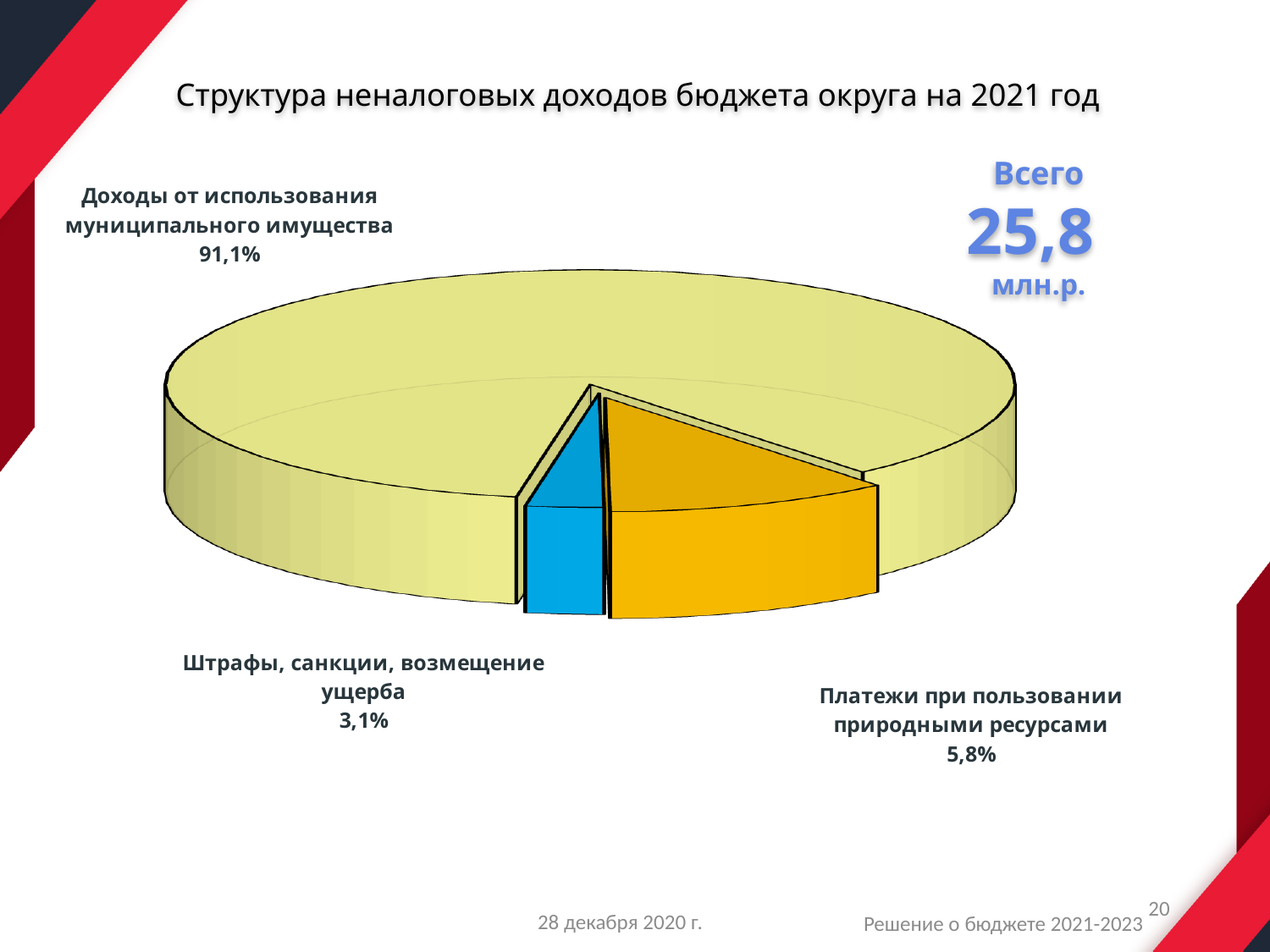
What share of non-tax revenues comes from 'Штрафы, санкции, возмещение ущерба'? 3,1% How many slices does the pie chart have? 3 Which category has the smallest share of the pie? Штрафы, санкции, возмещение ущерба What is the difference in percentage points between 'Платежи при пользовании природными ресурсами' and 'Штрафы, санкции, возмещение ущерба'? 2,7 What type of chart is shown on the slide? pie chart What share of non-tax revenues comes from 'Доходы от использования муниципального имущества'? 91,1% Which is larger: the share for 'Платежи при пользовании природными ресурсами' or for 'Штрафы, санкции, возмещение ущерба'? Платежи при пользовании природными ресурсами What is the title of the chart? Структура неналоговых доходов бюджета округа на 2021 год What is the difference in percentage points between 'Доходы от использования муниципального имущества' and 'Платежи при пользовании природными ресурсами'? 85,3 What share of non-tax revenues comes from 'Платежи при пользовании природными ресурсами'? 5,8% What is the total amount of non-tax revenues shown on the slide? 25,8 млн.р. Which category has the largest share of the pie? Доходы от использования муниципального имущества